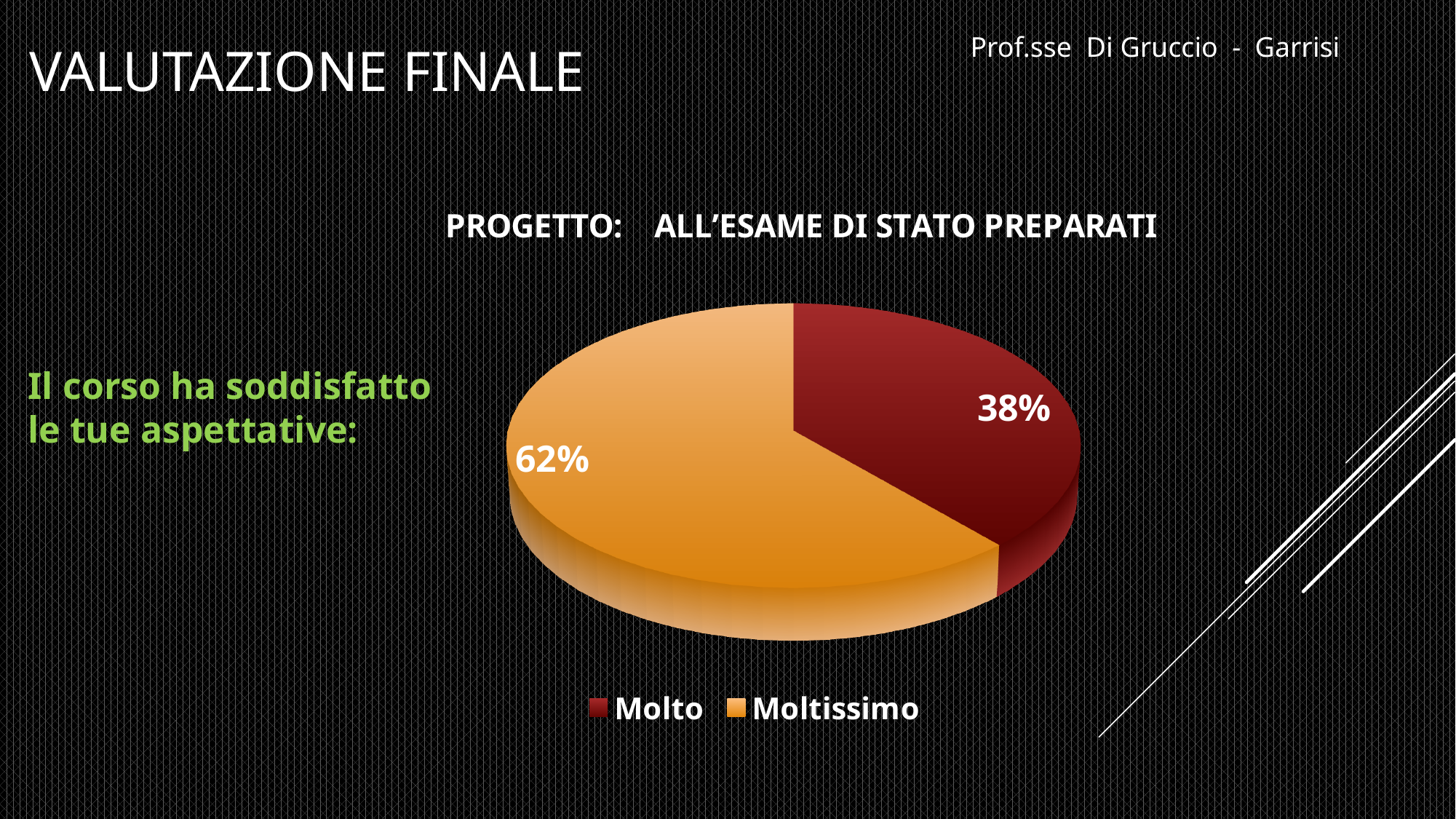
How many entries does the legend list? 2 What colour is the "Molto" slice in the pie chart? Dark red Which category has the largest slice of the pie? Moltissimo What share of the pie does the "Moltissimo" slice represent? 62% What is the difference in percentage points between the "Moltissimo" and "Molto" slices? 24 What kind of chart is shown on the slide? Pie chart How many slices does the pie chart have? 2 What share of the pie does the "Molto" slice represent? 38% What is the title of the chart? PROGETTO: ALL'ESAME DI STATO PREPARATI Which category has the smallest slice of the pie? Molto Which is larger, the "Molto" slice or the "Moltissimo" slice? Moltissimo